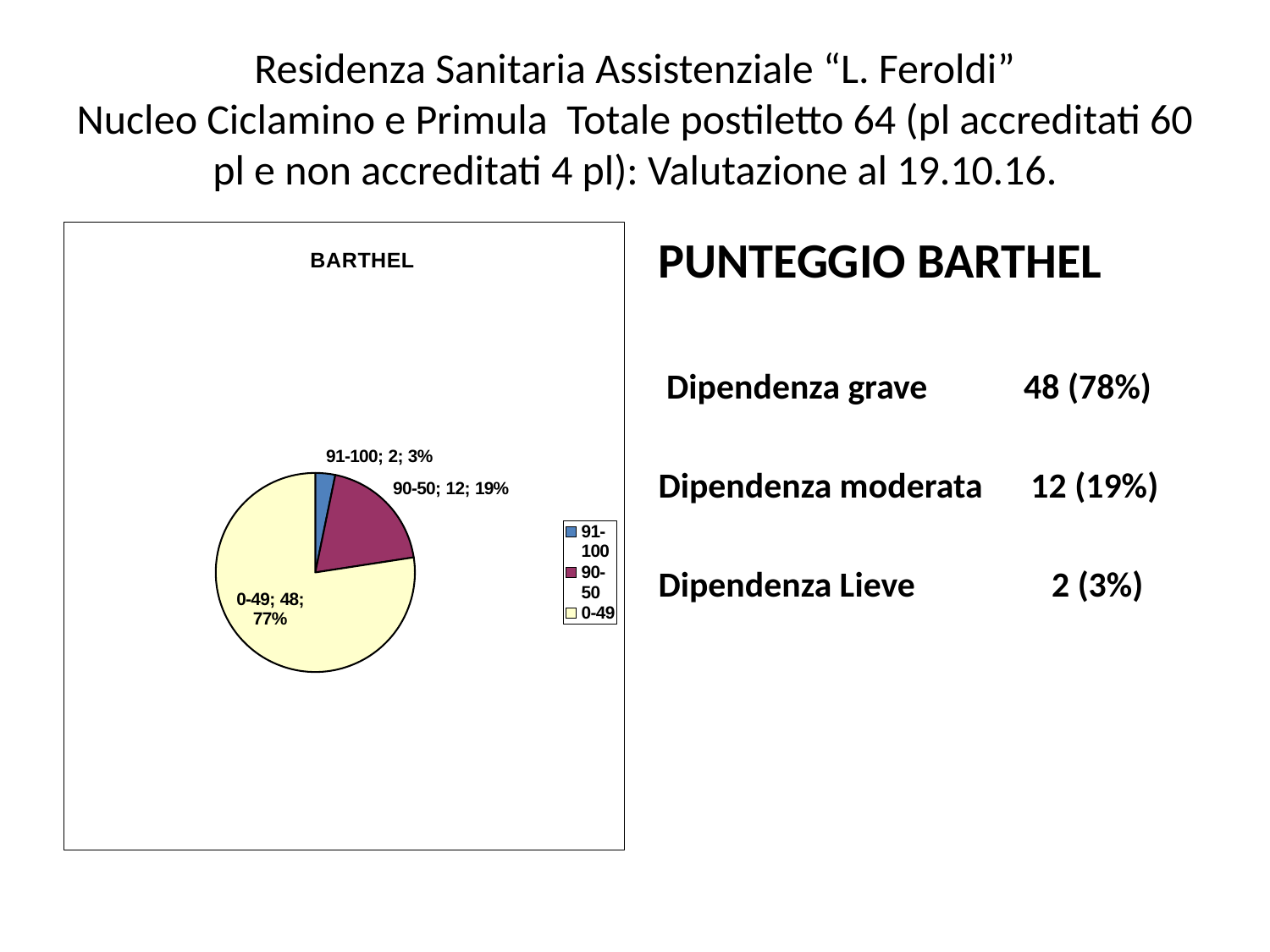
How many entries does the chart legend list? 3 What is the difference between the values for 0-49 and 90-50? 36 Which category has the largest slice of the pie? 0-49 What share of the pie does the 0-49 slice represent? 77% What type of chart is shown on the slide? pie chart What is the value for the 91-100 slice? 2 How many slices does the pie chart have? 3 What is the value for the 0-49 slice? 48 What is the title of the chart? BARTHEL What share of the pie does the 90-50 slice represent? 19% Which category has the smallest slice of the pie? 91-100 What is the value for the 90-50 slice? 12